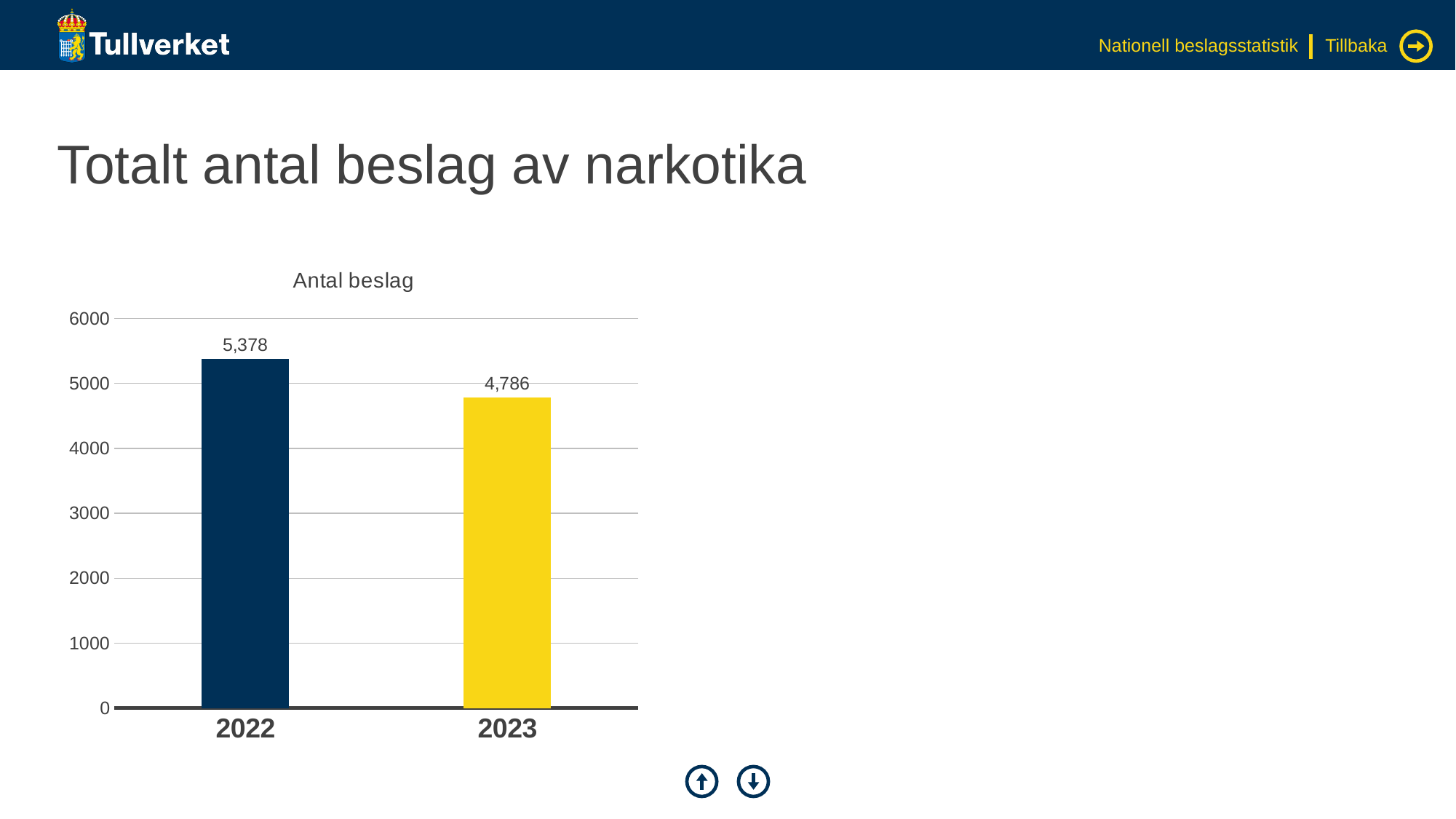
What is the value for 2022? 5,378 What is the title of the chart? Antal beslag What kind of chart is shown on the slide? bar chart What is the difference between the values for 2022 and 2023? 592 Is the value for 2023 greater or less than 5000? less Do the values rise or fall from 2022 to 2023? fall Which year has the highest number of seizures? 2022 Which is larger, the value for 2022 or the value for 2023? 2022 Is the value for 2022 greater or less than 5000? greater How many categories are shown on the x axis? 2 What is the value for 2023? 4,786 Which year has the lowest number of seizures? 2023